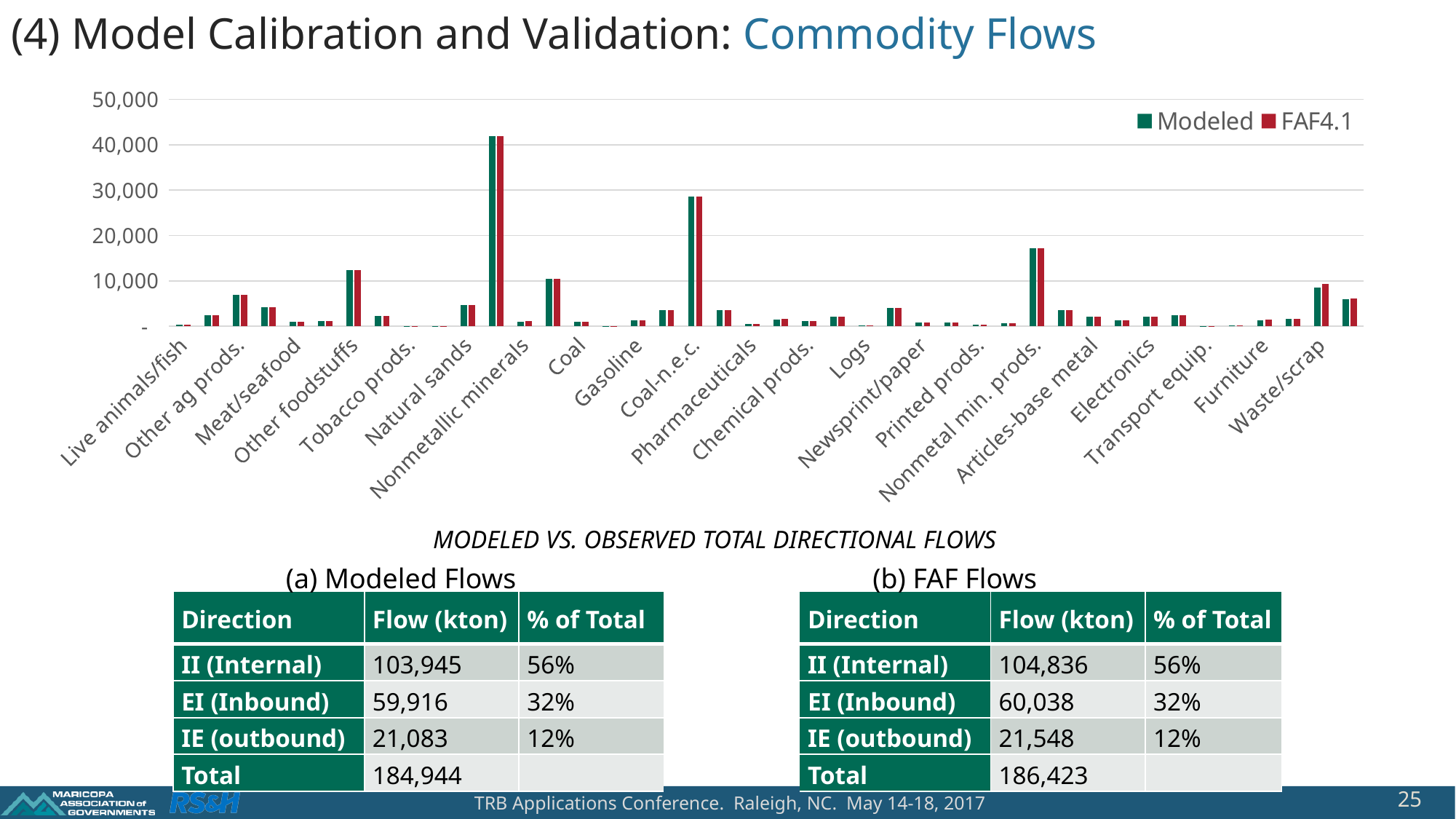
What are the two series named in the chart legend? Modeled and FAF4.1 Which colour represents the Modeled series in the chart? green Is the Modeled value for Nonmetallic minerals greater or less than 30,000? less Which has the larger FAF4.1 value, Other foodstuffs or Other ag prods.? Other foodstuffs Which has the larger Modeled value, Nonmetallic minerals or Coal-n.e.c.? Coal-n.e.c. Is the Modeled value for Nonmetal min. prods. greater or less than 20,000? less How many series does the chart legend list? 2 Is the FAF4.1 value for Coal-n.e.c. greater or less than 20,000? greater What kind of chart is shown on the slide? bar chart